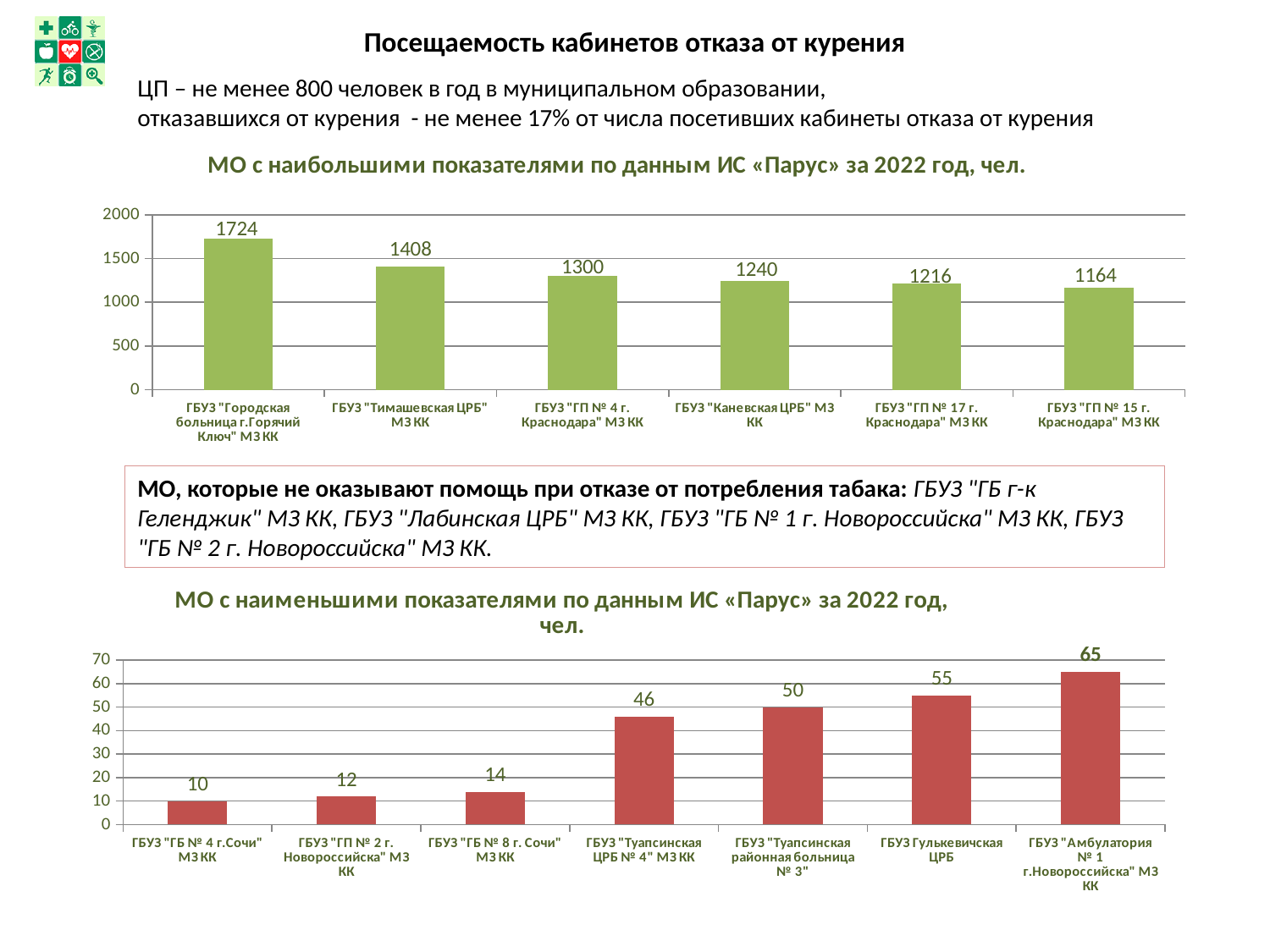
In the top chart (МО с наибольшими показателями), what is the value for ГБУЗ "Тимашевская ЦРБ" МЗ КК? 1408 In the bottom chart (МО с наименьшими показателями), how many categories are shown? 7 In the top chart (МО с наибольшими показателями), do the values rise or fall from left to right? fall In the bottom chart (МО с наименьшими показателями), which category has the lowest value? ГБУЗ "ГБ № 4 г.Сочи" МЗ КК In the bottom chart (МО с наименьшими показателями), what is the difference between ГБУЗ "ГБ № 8 г. Сочи" МЗ КК and ГБУЗ "ГБ № 4 г.Сочи" МЗ КК? 4 What type of chart is the top chart (МО с наибольшими показателями)? bar chart In the top chart (МО с наибольшими показателями), how many categories are shown? 6 In the top chart (МО с наибольшими показателями), which category has the highest value? ГБУЗ "Городская больница г.Горячий Ключ" МЗ КК In the bottom chart (МО с наименьшими показателями), what is the value for ГБУЗ "Туапсинская ЦРБ № 4" МЗ КК? 46 In the top chart (МО с наибольшими показателями), what is the difference between ГБУЗ "Городская больница г.Горячий Ключ" МЗ КК and ГБУЗ "ГП № 15 г. Краснодара" МЗ КК? 560 In the bottom chart (МО с наименьшими показателями), which is larger: ГБУЗ Гулькевичская ЦРБ or ГБУЗ "Туапсинская районная больница № 3"? ГБУЗ Гулькевичская ЦРБ In the bottom chart (МО с наименьшими показателями), which category has the highest value? ГБУЗ "Амбулатория № 1 г.Новороссийска" МЗ КК